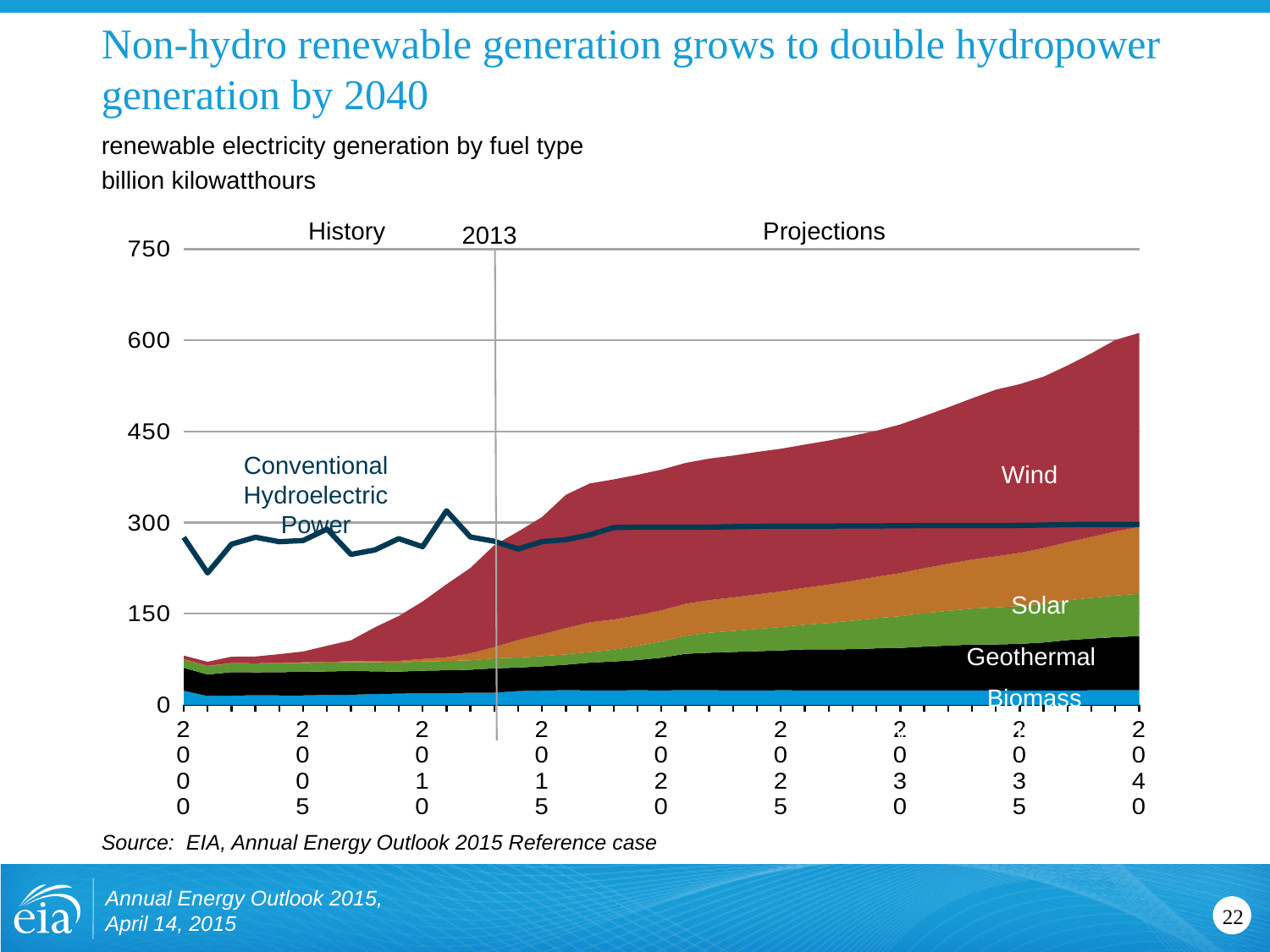
Which fuel type contributes the smallest share of non-hydro renewable generation in 2040? Biomass How many year labels are shown along the x axis? 9 How many fuel-type series are labeled on the chart? 5 What unit is the y axis of the chart measured in? billion kilowatthours Is the total non-hydro renewable generation in 2040 greater or less than 600 billion kilowatthours? greater Does total non-hydro renewable generation rise or fall from 2000 to 2040? rise Which year marks the boundary between History and Projections on the chart? 2013 Is Conventional Hydroelectric Power generation in 2000 greater or less than 300 billion kilowatthours? less Is the total non-hydro renewable generation in 2000 greater or less than 150 billion kilowatthours? less In 2040, which is larger: total non-hydro renewable generation or Conventional Hydroelectric Power generation? Total non-hydro renewable generation Which fuel type contributes the largest share of non-hydro renewable generation in 2040? Wind What kind of chart is shown on the slide? Stacked area chart with a line